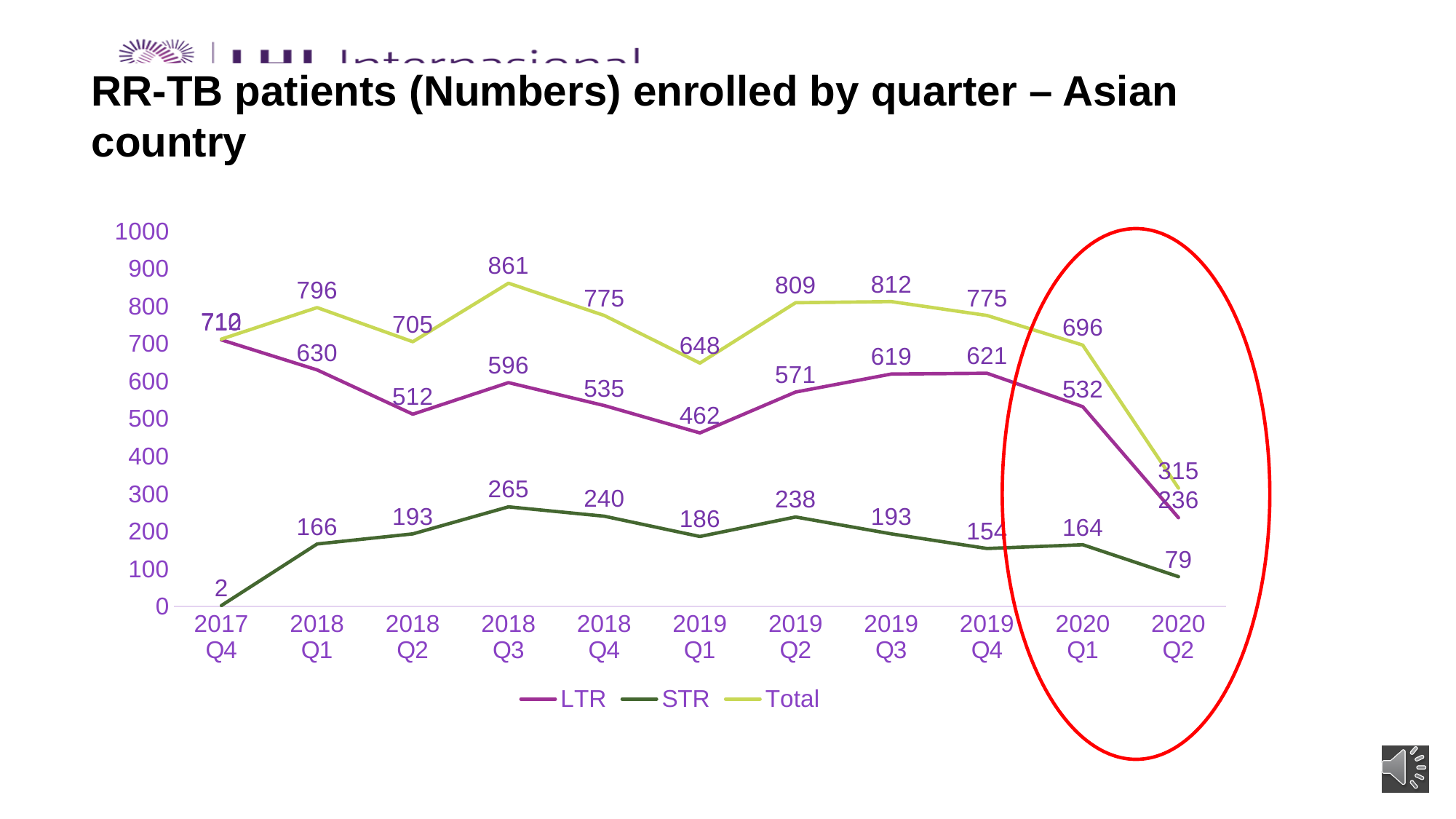
In which quarter is the STR series lowest? 2017 Q4 In which quarter is the Total series highest? 2018 Q3 What is the difference between the Total and LTR values in 2020 Q1? 164 How many series does the legend list? 3 What is the LTR value for 2019 Q1? 462 What is the Total value for 2018 Q3? 861 How many quarters are plotted along the x axis? 11 Does the Total series rise or fall from 2019 Q3 to 2020 Q2? fall What kind of chart is shown on the slide? line chart What is the title of the chart? RR-TB patients (Numbers) enrolled by quarter – Asian country Which is larger, the LTR value in 2019 Q3 or the LTR value in 2019 Q4? 2019 Q4 What is the STR value for 2020 Q2? 79